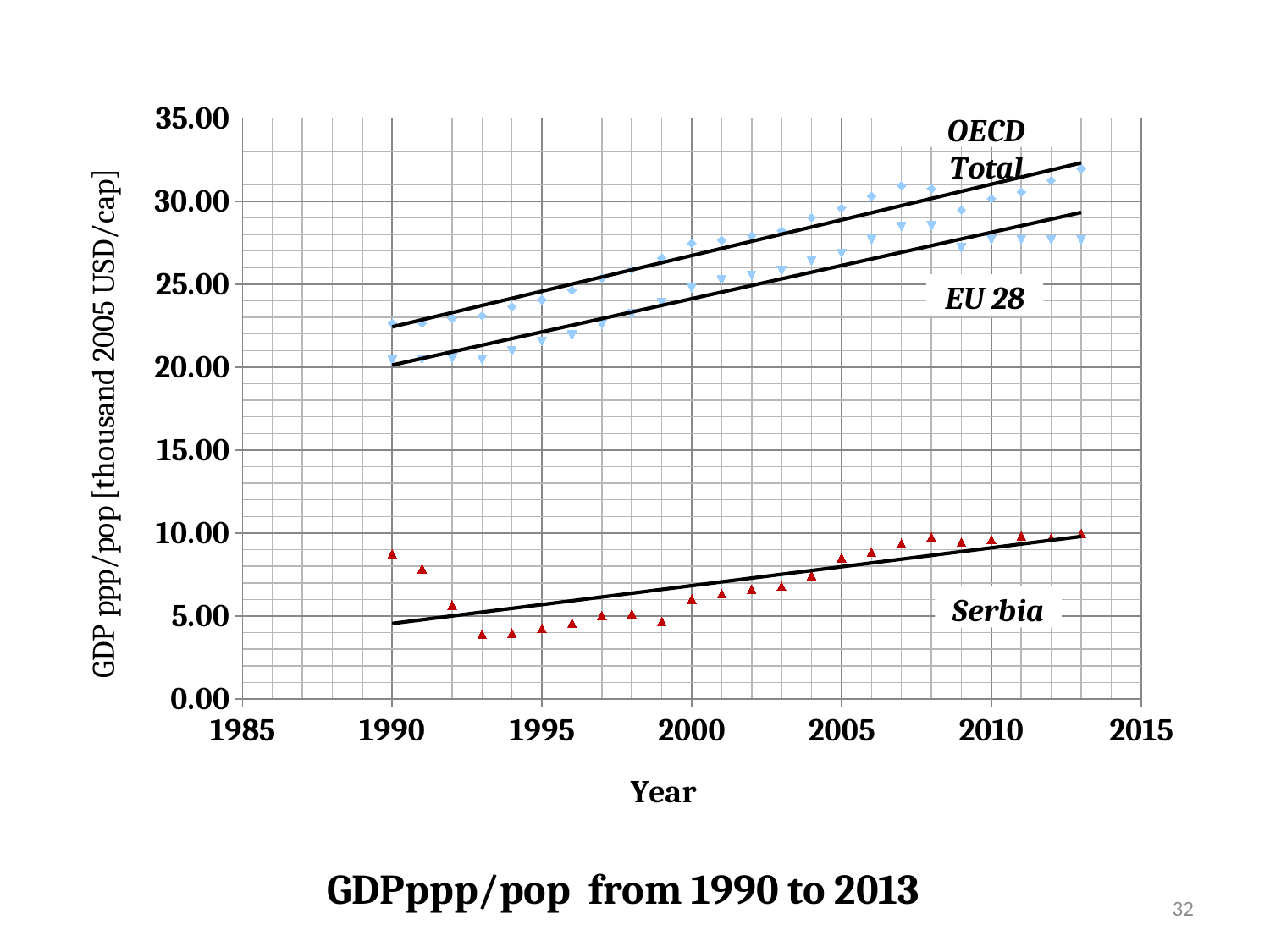
Is the value for OECD Total in 2013 greater or less than 30.00? greater What kind of chart is shown on the slide? Scatter chart Is the value for Serbia in 1994 greater or less than 5.00? less Does the OECD Total series generally rise or fall from 1990 to 2013? Rise What is the title of the chart? GDPppp/pop from 1990 to 2013 Is the value for Serbia in 1990 greater or less than 5.00? greater In 2005, which is larger: the value for OECD Total or the value for EU 28? OECD Total Does the Serbia series rise or fall between 1990 and 1994? Fall Which series has the lowest values throughout the chart? Serbia Which series has the highest values throughout the chart? OECD Total How many data series are plotted on the chart? 3